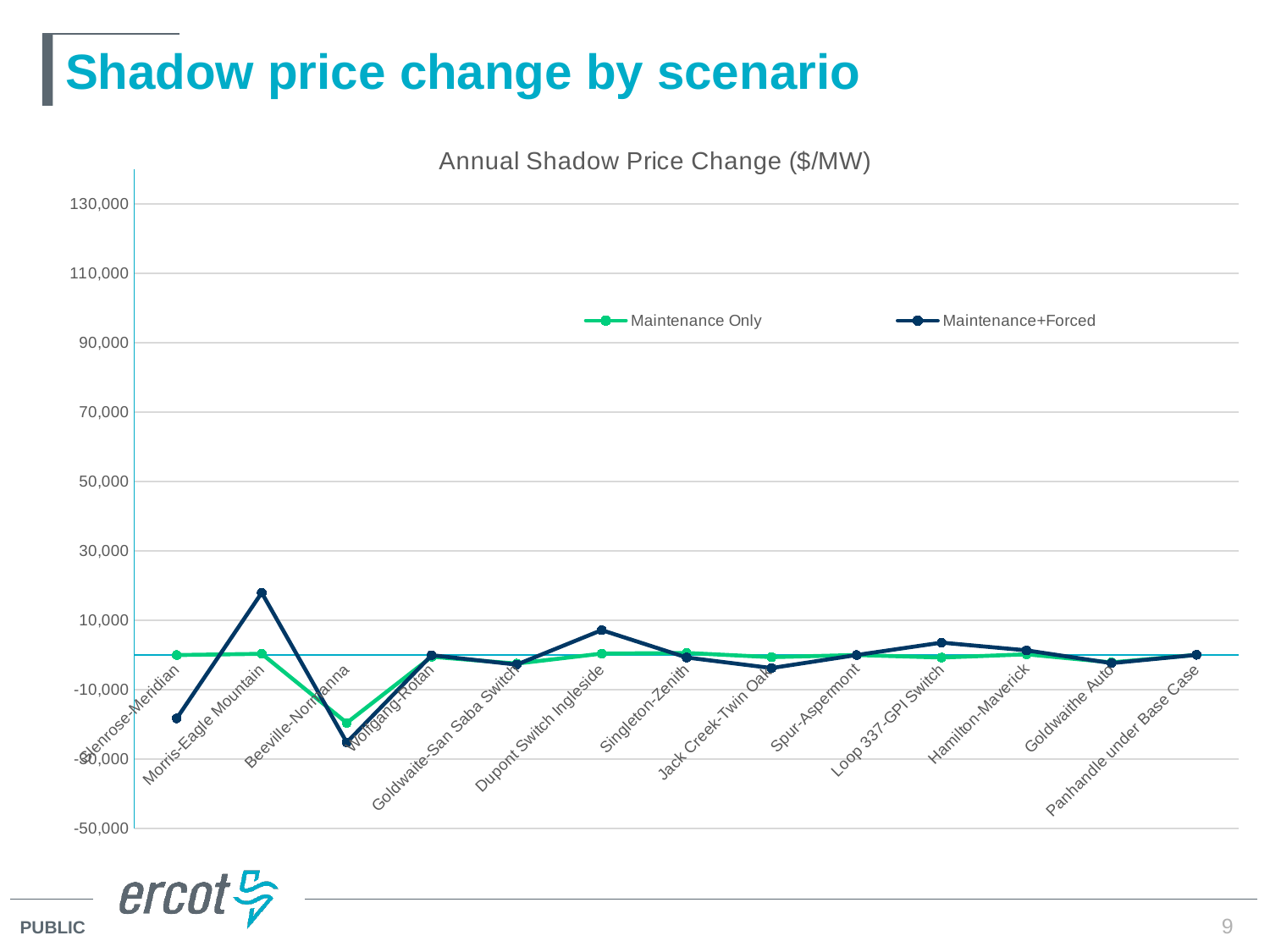
For which category is the Maintenance+Forced value lowest? Beeville-Normanna Is the Maintenance+Forced value for Glenrose-Meridian greater or less than -10,000? less Which colour is used for the Maintenance Only series? Green How many series does the legend list? 2 For which category is the Maintenance+Forced value highest? Morris-Eagle Mountain How many categories are plotted along the x axis? 13 What kind of chart is shown on the slide? Line chart For which category is the Maintenance Only value lowest? Beeville-Normanna Is the Maintenance+Forced value for Morris-Eagle Mountain greater or less than 10,000? greater What is the title of the chart? Annual Shadow Price Change ($/MW) Is the Maintenance+Forced value for Beeville-Normanna greater or less than -10,000? less At Morris-Eagle Mountain, which series has the larger value, Maintenance Only or Maintenance+Forced? Maintenance+Forced